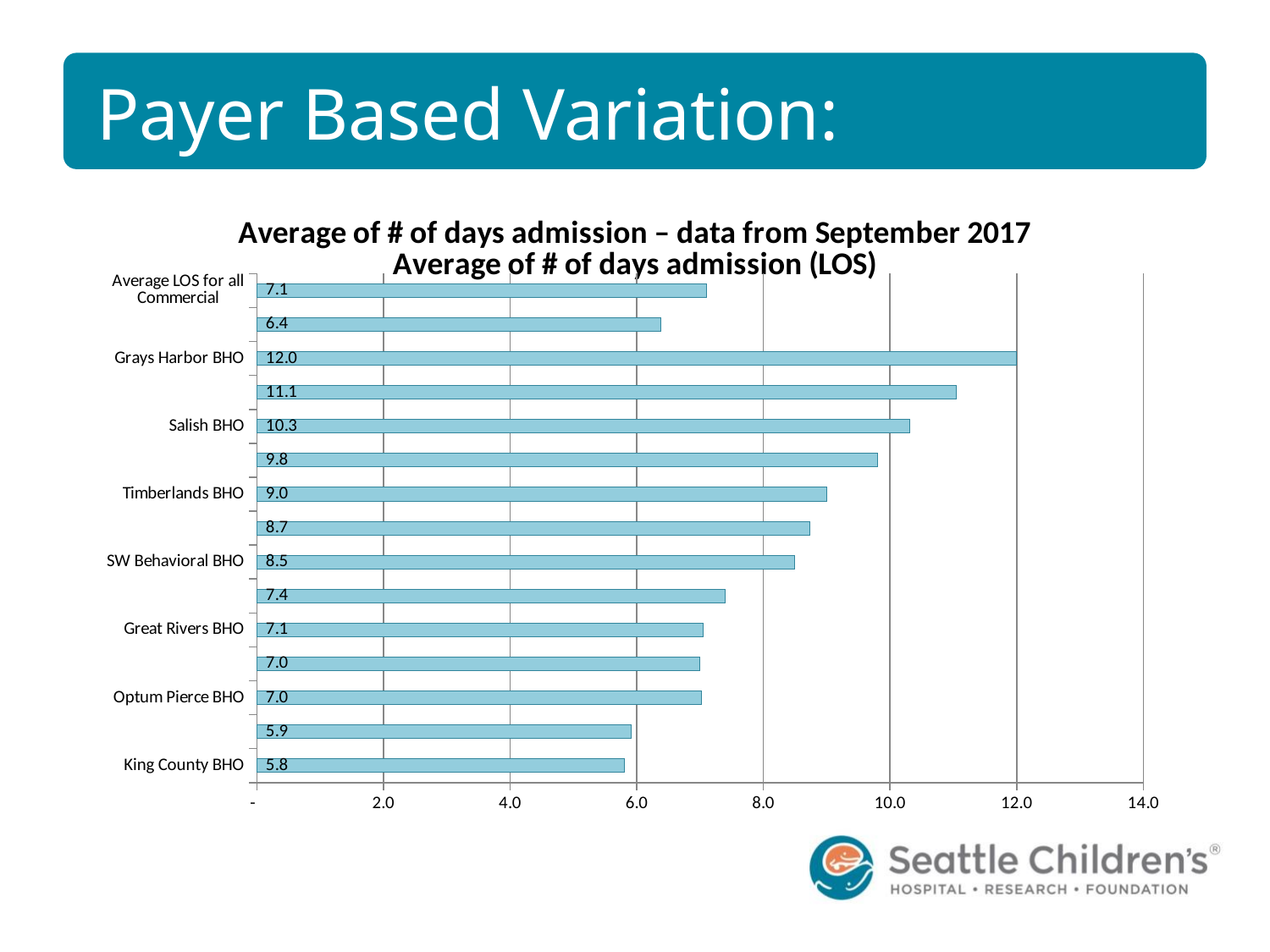
Which labeled category has the lowest average number of days admission? King County BHO Which is larger, the value for Salish BHO or the value for Timberlands BHO? Salish BHO What kind of chart is shown on the slide? bar chart What is the average number of days admission for Grays Harbor BHO? 12.0 Which labeled category has the highest average number of days admission? Grays Harbor BHO What is the value shown for Salish BHO? 10.3 What is the value shown for Average LOS for all Commercial? 7.1 How many bars are plotted in the chart? 15 What is the value shown for SW Behavioral BHO? 8.5 What is the difference between the values for Grays Harbor BHO and King County BHO? 6.2 What is the value shown for King County BHO? 5.8 Is the value for Great Rivers BHO greater or less than 8.0? less